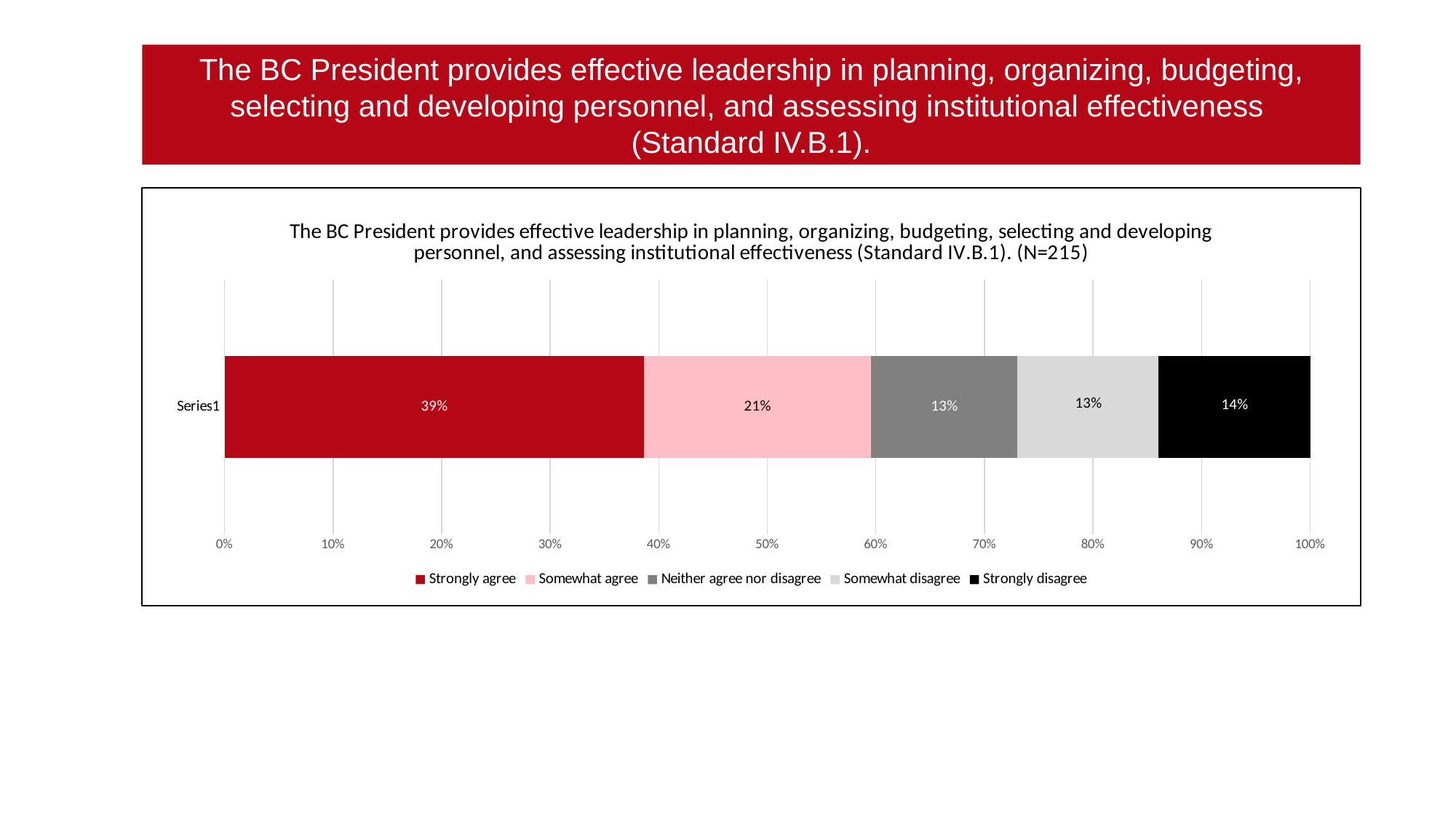
Which response category has the largest share? Strongly agree What percentage of respondents selected "Somewhat agree"? 21% What is the sample size (N) stated in the chart title? 215 What colour represents "Strongly disagree" in the chart? Black What is the difference between the "Strongly agree" and "Somewhat agree" percentages? 18% What percentage of respondents selected "Neither agree nor disagree"? 13% What percentage of respondents selected "Strongly disagree"? 14% What percentage of respondents selected "Strongly agree"? 39% What is the total of the stacked bar? 100% Which is larger, the "Somewhat agree" share or the "Strongly disagree" share? Somewhat agree How many series does the legend list? 5 What kind of chart is shown on the slide? Stacked bar chart